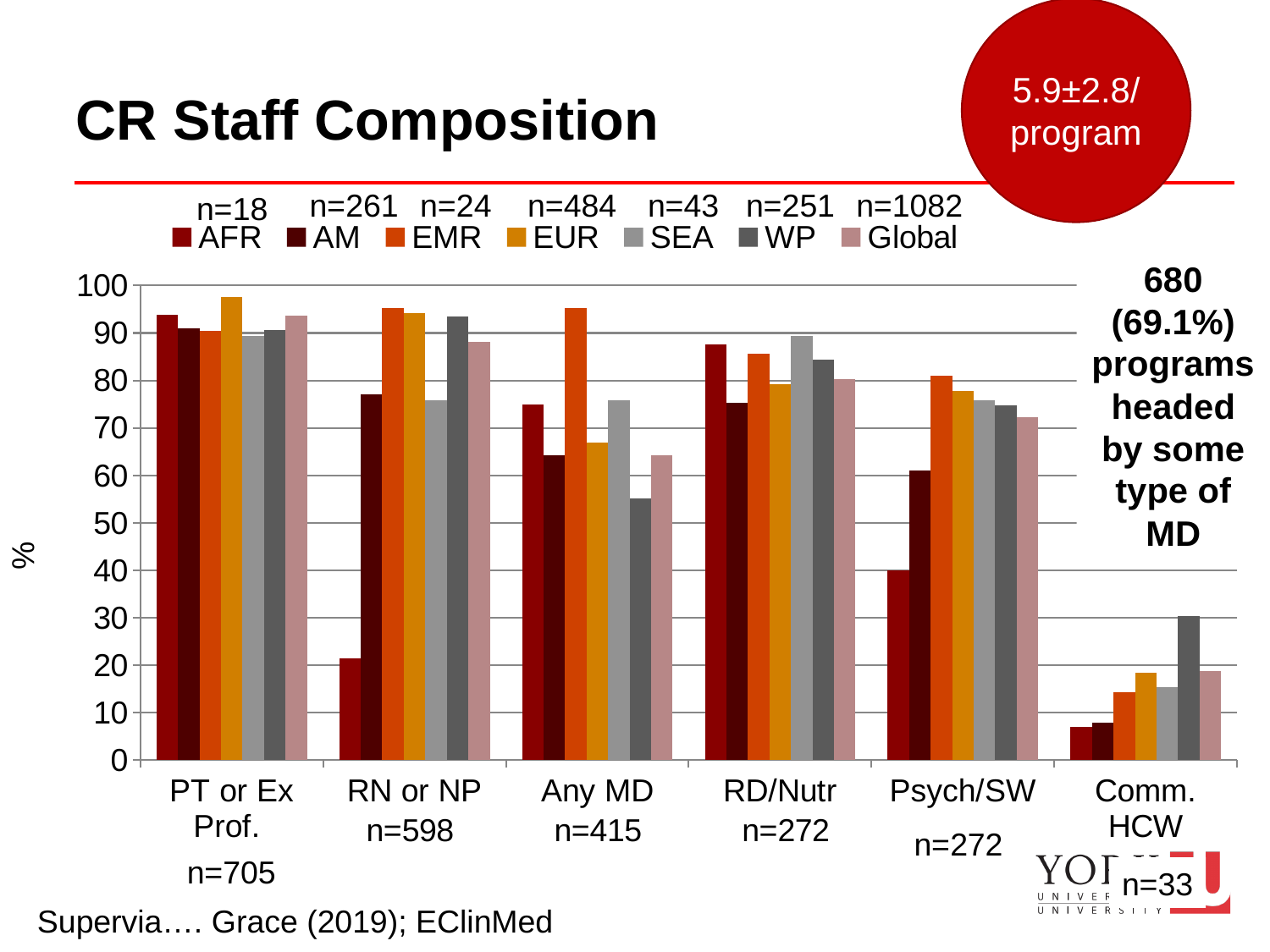
Which region has the lowest value in the Psych/SW category? AFR Which region has the lowest value in the RN or NP category? AFR Is the value for AFR in the RN or NP category greater or less than 30? less How many staff categories are shown along the x axis? 6 Is the value for EMR in the Any MD category greater or less than 90? greater What is the sample size (n) shown for the Global series in the legend? n=1082 In the Any MD category, which is larger: the value for AFR or the value for WP? AFR Is the value for AM in the RN or NP category greater or less than 70? greater What kind of chart is shown on the slide? bar chart How many series does the legend list? 7 Which region has the highest value in the Comm. HCW category? WP